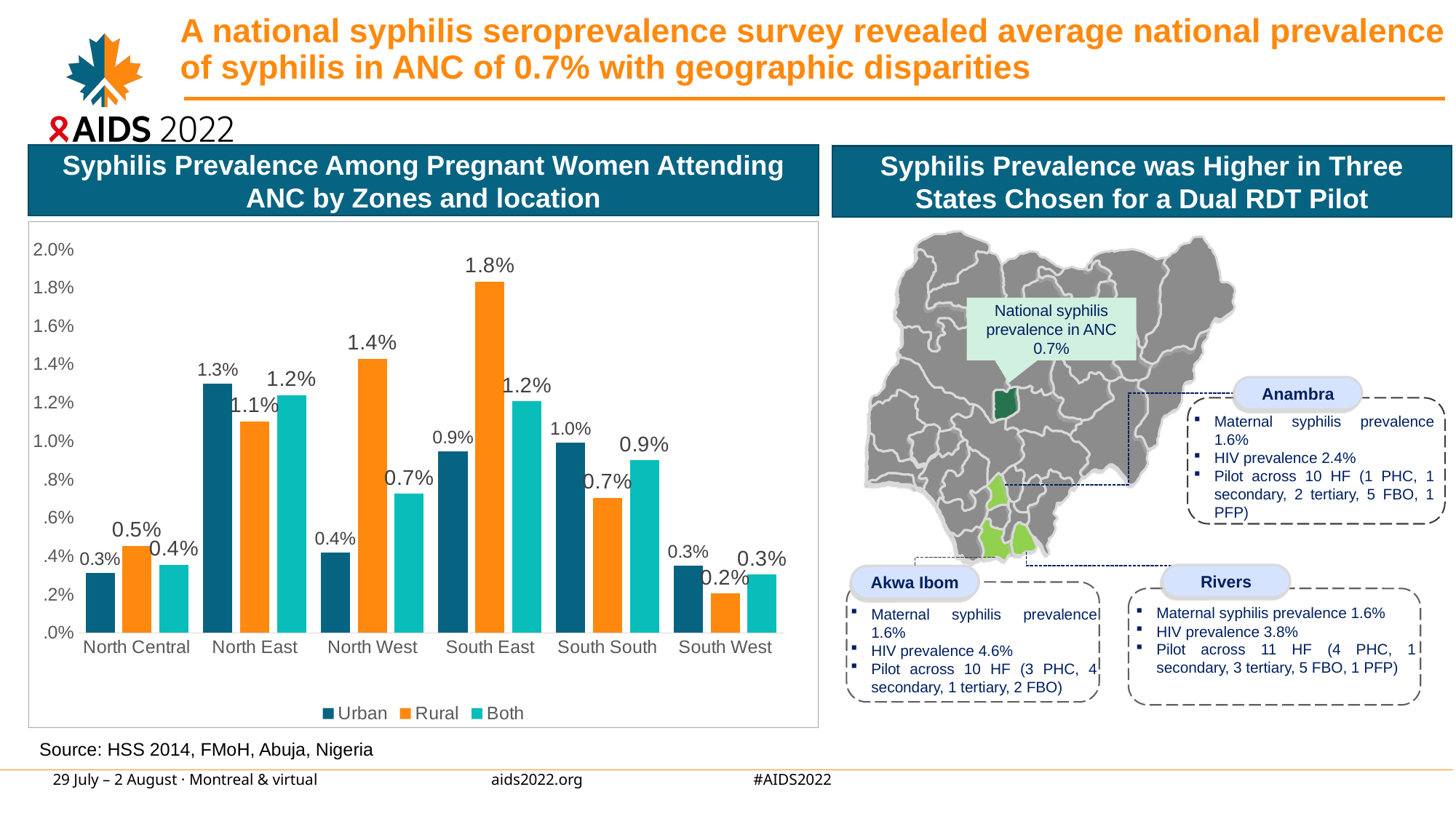
Which zone has the lowest Rural prevalence? South West Which is larger for South South: the Urban value or the Rural value? Urban What is the Urban syphilis prevalence for North East? 1.3% What type of chart is shown? Bar chart How many series does the legend list? 3 Which zone has the highest Rural prevalence? South East What is the 'Both' value for North West? 0.7% What is the Rural syphilis prevalence for South East? 1.8% How many zones are shown on the x axis? 6 What is the title of the chart? Syphilis Prevalence Among Pregnant Women Attending ANC by Zones and location What is the difference between the Rural and Urban values for North West? 1.0% What is the difference between the Rural values for South East and North Central? 1.3%